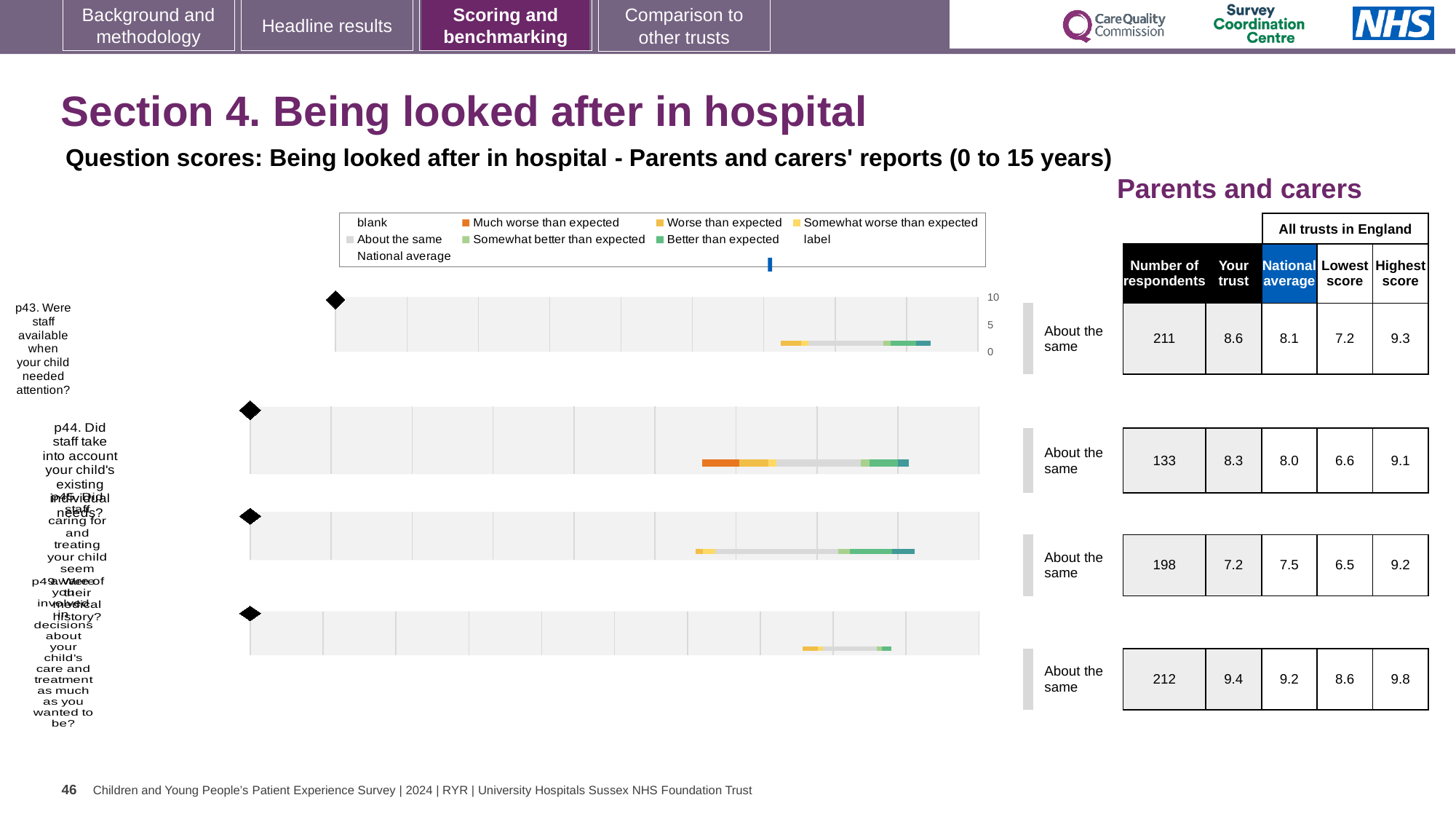
What is the highest 'Your trust' score shown in the table beside the charts? 9.4 What is the lowest 'Your trust' score shown in the table beside the charts? 7.2 In the table beside the charts, what is the National average for p44 (Did staff take into account your child's existing individual needs?)? 8.0 In the legend, what colour represents 'Better than expected'? teal In the table beside the charts, how many respondents are listed for p43? 211 For p43, what is the difference between the Highest score and the Lowest score in the table? 2.1 What kind of chart is used to show the question scores on this slide? bar chart In the table beside the charts, what is the 'Your trust' score for p43 (Were staff available when your child needed attention?)? 8.6 What benchmark category is shown next to each of the four charts? About the same For p43, which is larger: the 'Your trust' score or the National average? Your trust How many question bar charts are shown on the slide? 4 In the legend, what colour represents 'Much worse than expected'? orange